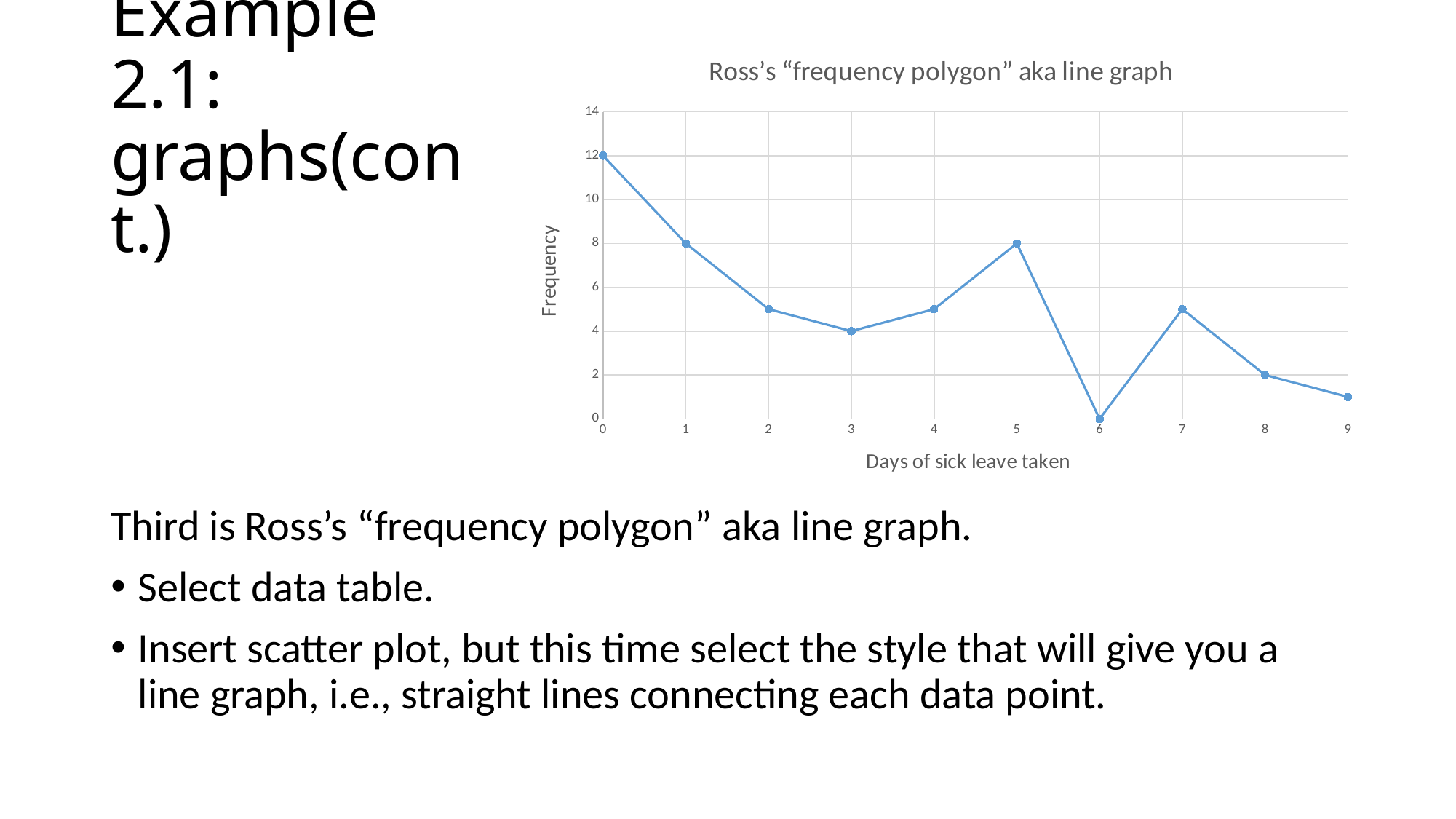
How many data points are plotted on the chart? 10 Is the frequency for 7 days of sick leave taken greater or less than 4? greater Which number of days of sick leave taken has the lowest frequency? 6 Which has a higher frequency: 3 days or 5 days of sick leave taken? 5 days Which number of days of sick leave taken has the highest frequency? 0 What is the title of the chart? Ross's "frequency polygon" aka line graph What is the frequency for 6 days of sick leave taken? 0 What is the frequency for 0 days of sick leave taken? 12 What is the difference in frequency between 0 days and 1 day of sick leave taken? 4 What is the frequency for 1 day of sick leave taken? 8 What kind of chart is shown on the slide? line chart What is the frequency for 8 days of sick leave taken? 2